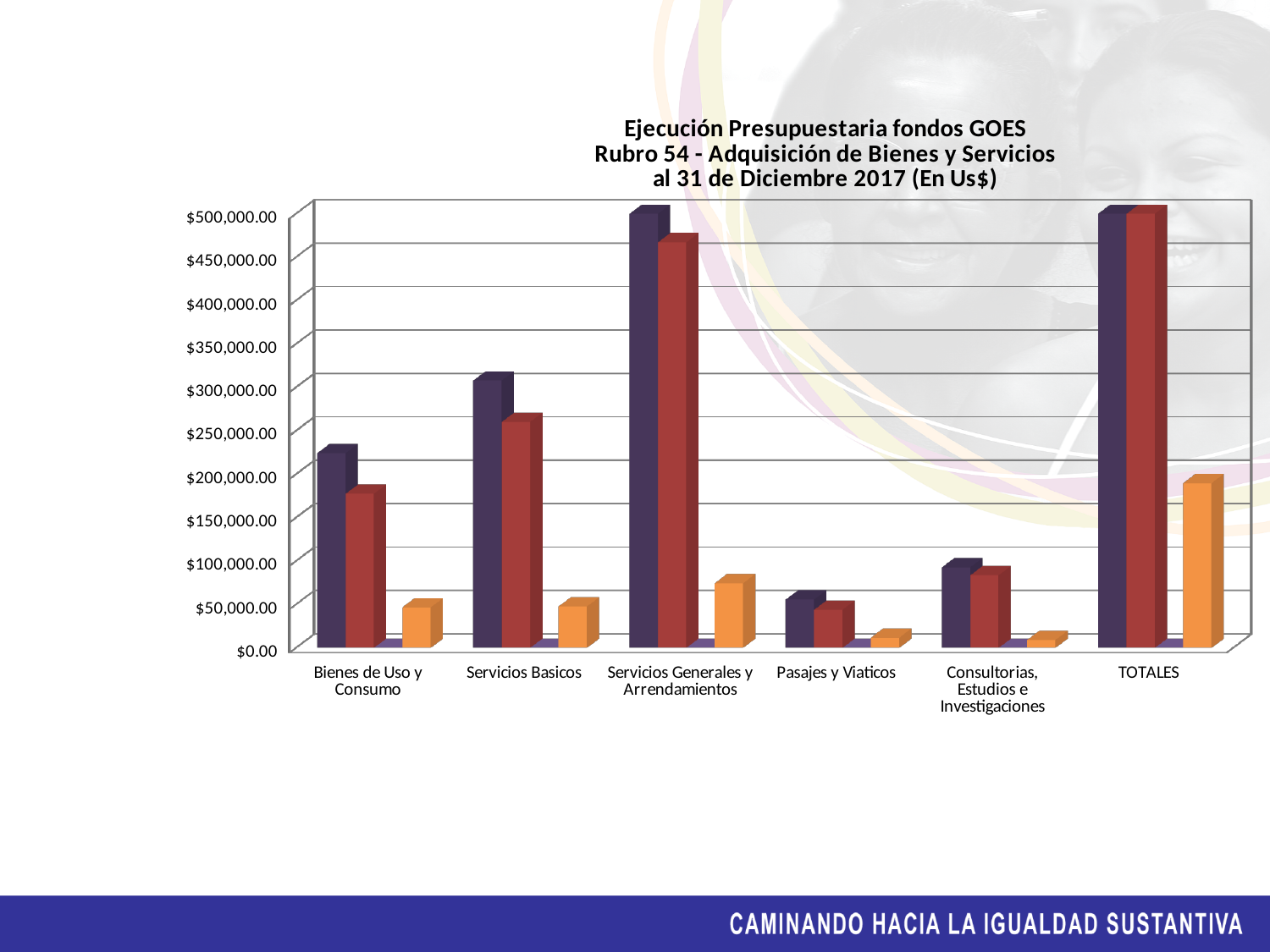
Which has the larger orange bar, Servicios Generales y Arrendamientos or Pasajes y Viaticos? Servicios Generales y Arrendamientos Is the orange bar for TOTALES greater or less than $150,000.00? greater What kind of chart is shown on the slide? bar chart Is the red bar for Servicios Generales y Arrendamientos greater or less than $400,000.00? greater Is the dark purple bar for Consultorias, Estudios e Investigaciones greater or less than $50,000.00? greater How many categories are shown along the x axis of the chart? 6 Which has the larger dark purple bar, Servicios Basicos or Bienes de Uso y Consumo? Servicios Basicos Excluding TOTALES, which category has the lowest dark purple bar? Pasajes y Viaticos What is the title of the chart? Ejecución Presupuestaria fondos GOES Rubro 54 - Adquisición de Bienes y Servicios al 31 de Diciembre 2017 (En Us$)